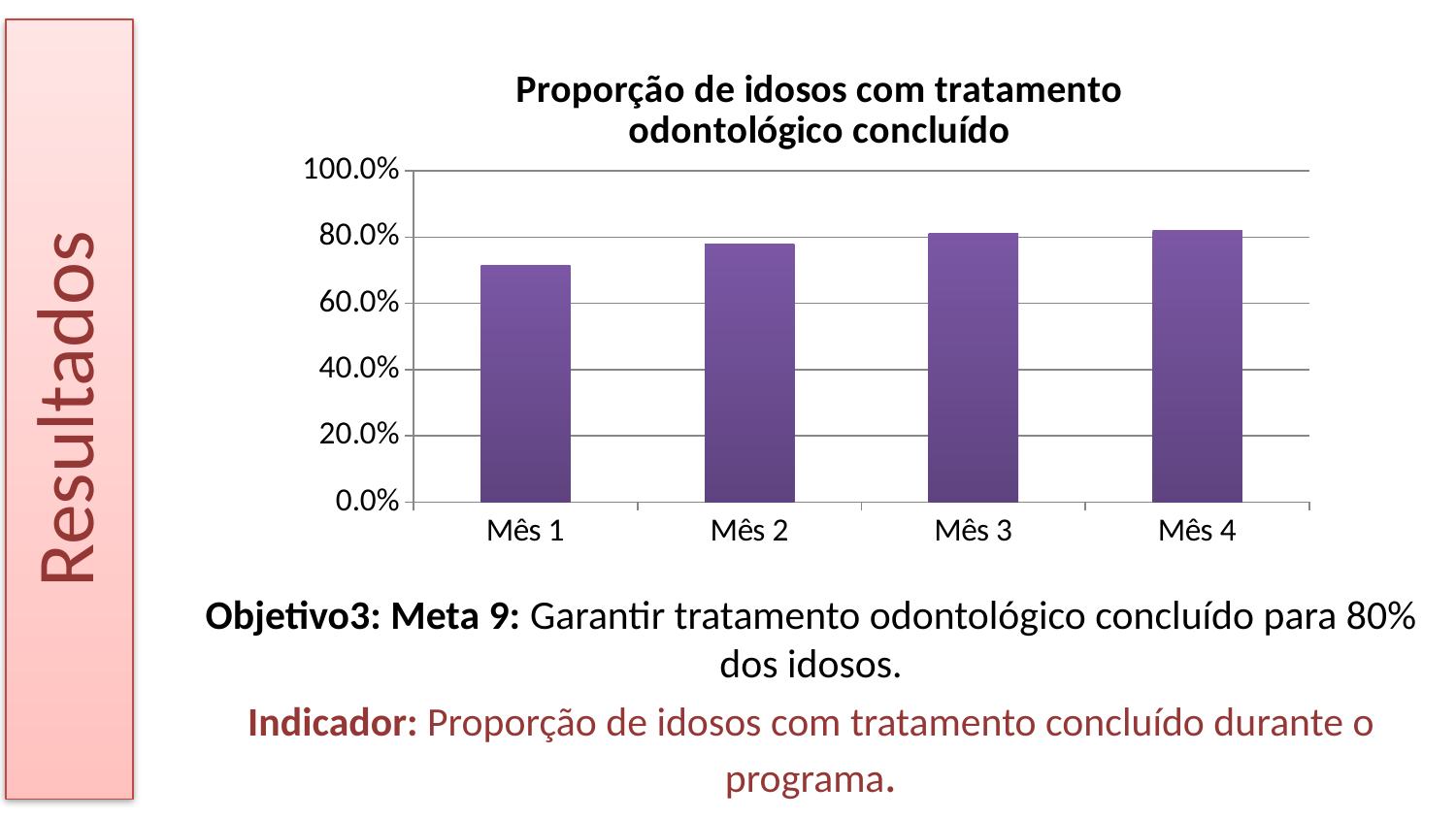
What colour are the bars in the chart? purple Which is larger, the value for Mês 1 or the value for Mês 2? Mês 2 What kind of chart is shown on the slide? bar chart Do the values rise or fall from Mês 1 to Mês 4? rise Is the value for Mês 1 greater or less than 80.0%? less How many categories (months) are plotted on the chart? 4 Is the value for Mês 1 greater or less than 60.0%? greater Which month has the lowest proportion of elderly with completed dental treatment? Mês 1 What is the title of the chart? Proporção de idosos com tratamento odontológico concluído Is the value for Mês 4 greater or less than 100.0%? less Which is larger, the value for Mês 1 or the value for Mês 4? Mês 4